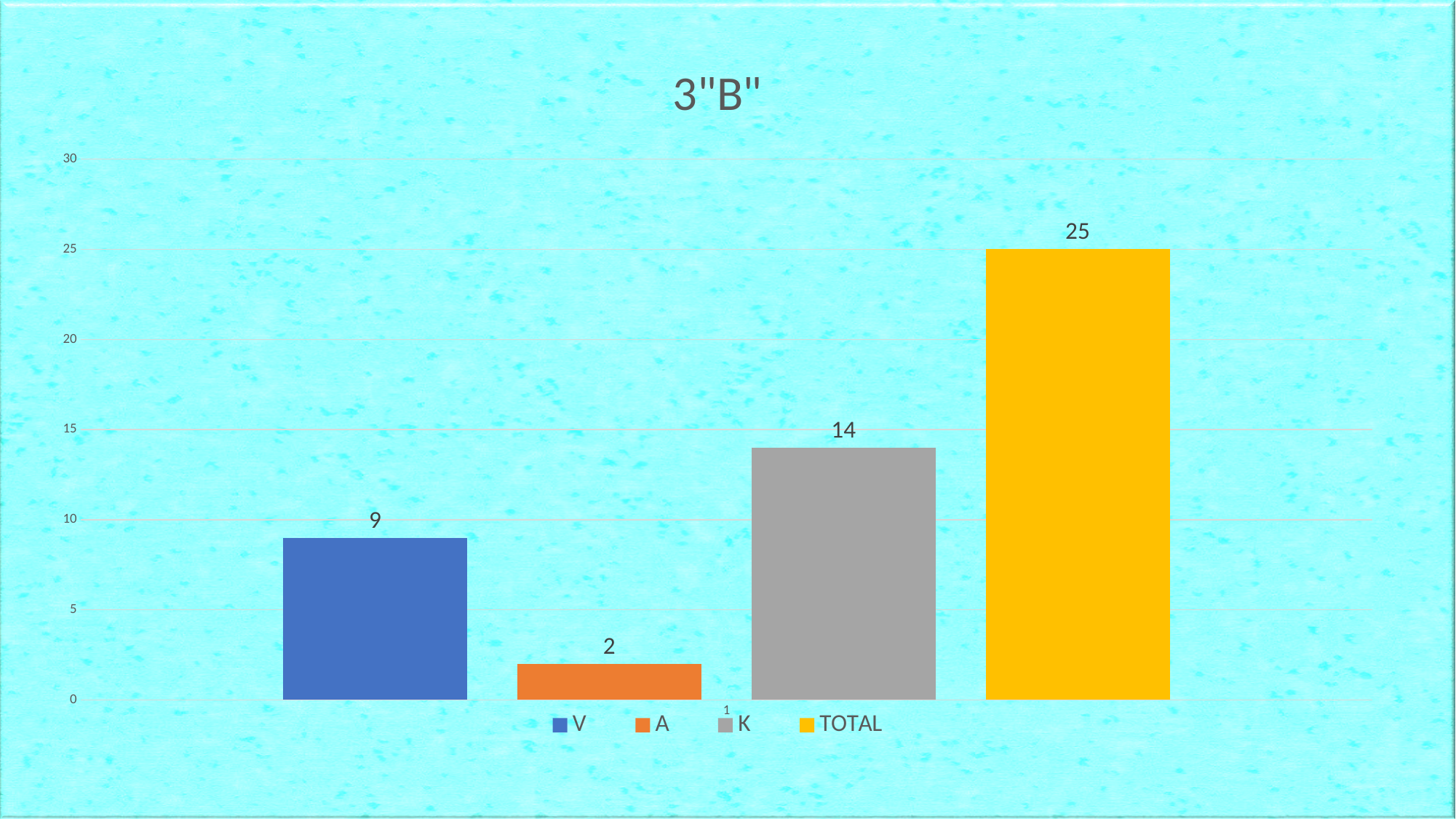
Which series has the lowest value? A Which is larger, the value for V or the value for K? K What is the value for A? 2 What is the difference between the values for K and V? 5 What is the value for TOTAL? 25 What kind of chart is shown? bar chart What is the value for K? 14 What is the title of the chart? 3"B" What is the value for V? 9 What is the difference between the values for TOTAL and K? 11 Which series has the highest value? TOTAL How many series does the legend list? 4